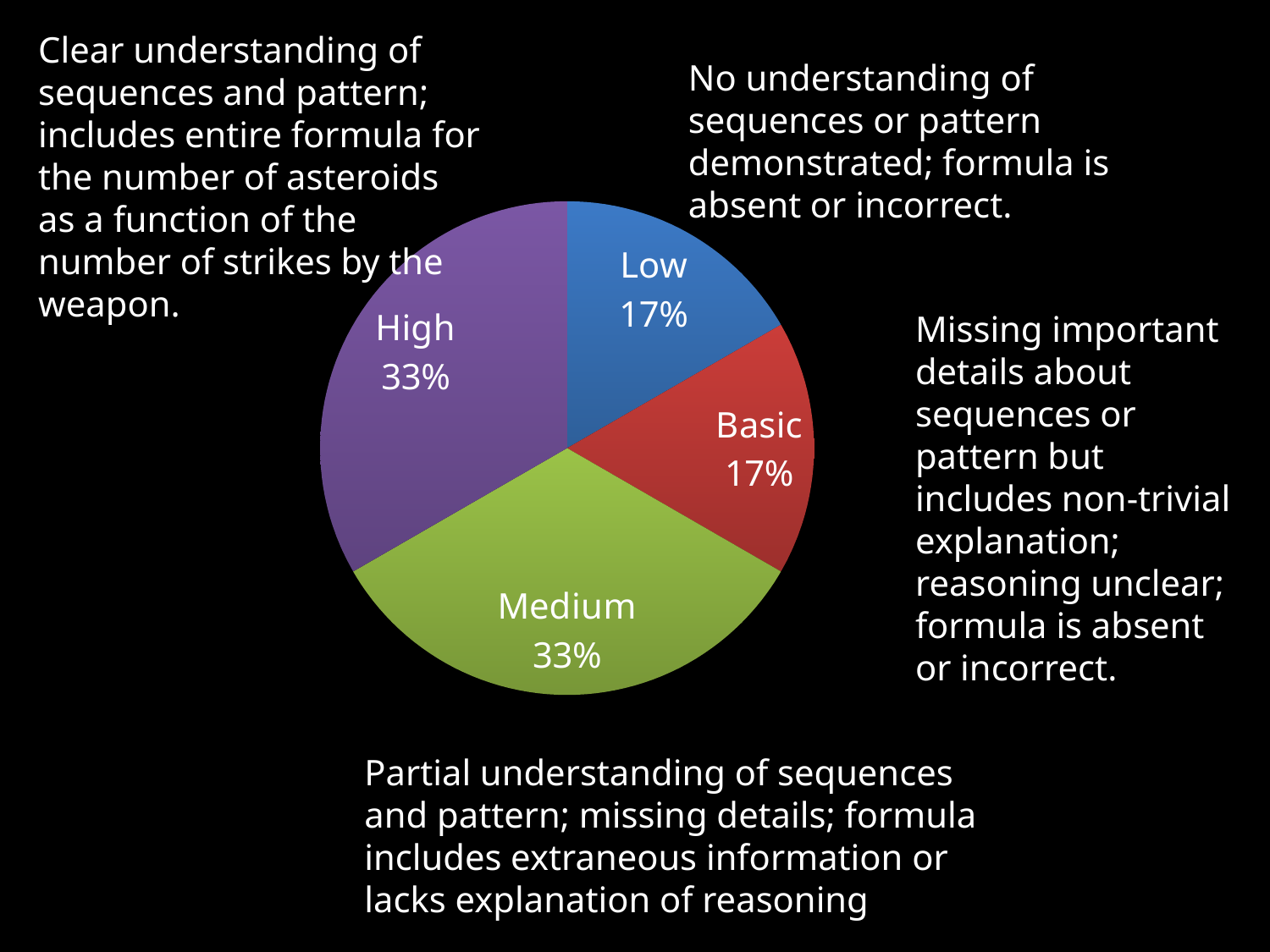
What kind of chart is shown on the slide? pie chart What is the difference in percentage points between the High slice and the Low slice? 16 What percentage is shown for the Medium slice? 33% What colour is the Low slice? blue What percentage is shown for the High slice? 33% What percentage is shown for the Low slice? 17% What colour is the Medium slice? green What percentage is shown for the Basic slice? 17% How many slices does the pie chart have? 4 Which is larger, the Medium slice or the Basic slice? Medium Which is larger, the High slice or the Low slice? High What is the combined share of the Low and Basic slices? 34%